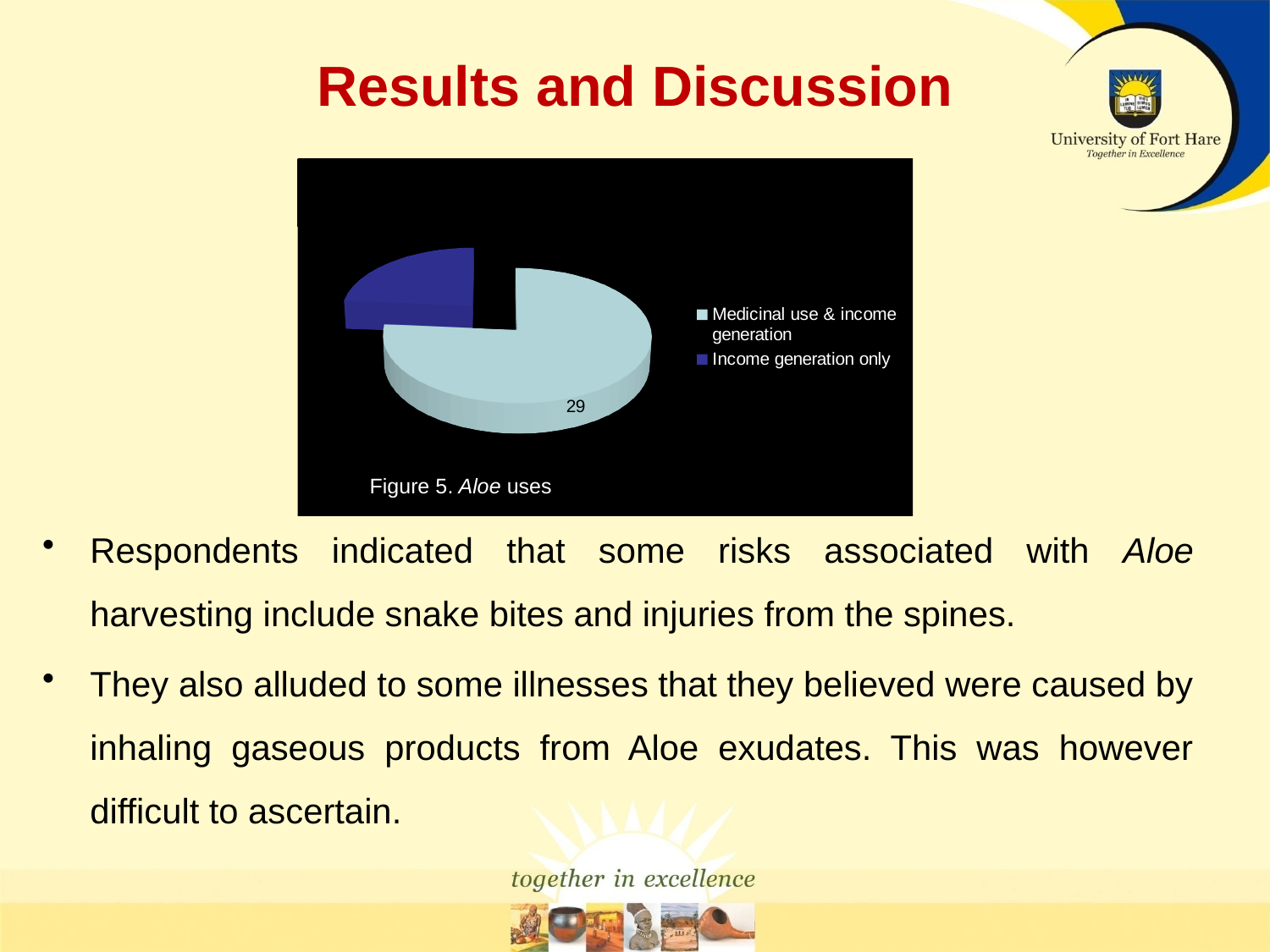
What is the figure caption shown below the pie chart? Figure 5. Aloe uses What kind of chart is shown on the slide? pie chart Which category has the smallest slice of the pie chart? Income generation only How many entries does the legend of the pie chart list? 2 Which category has the largest slice of the pie chart? Medicinal use & income generation How many slices does the pie chart have? 2 What colour is the 'Income generation only' slice in the pie chart? dark blue Which slice is larger: 'Medicinal use & income generation' or 'Income generation only'? Medicinal use & income generation What value is labelled on the 'Medicinal use & income generation' slice? 29